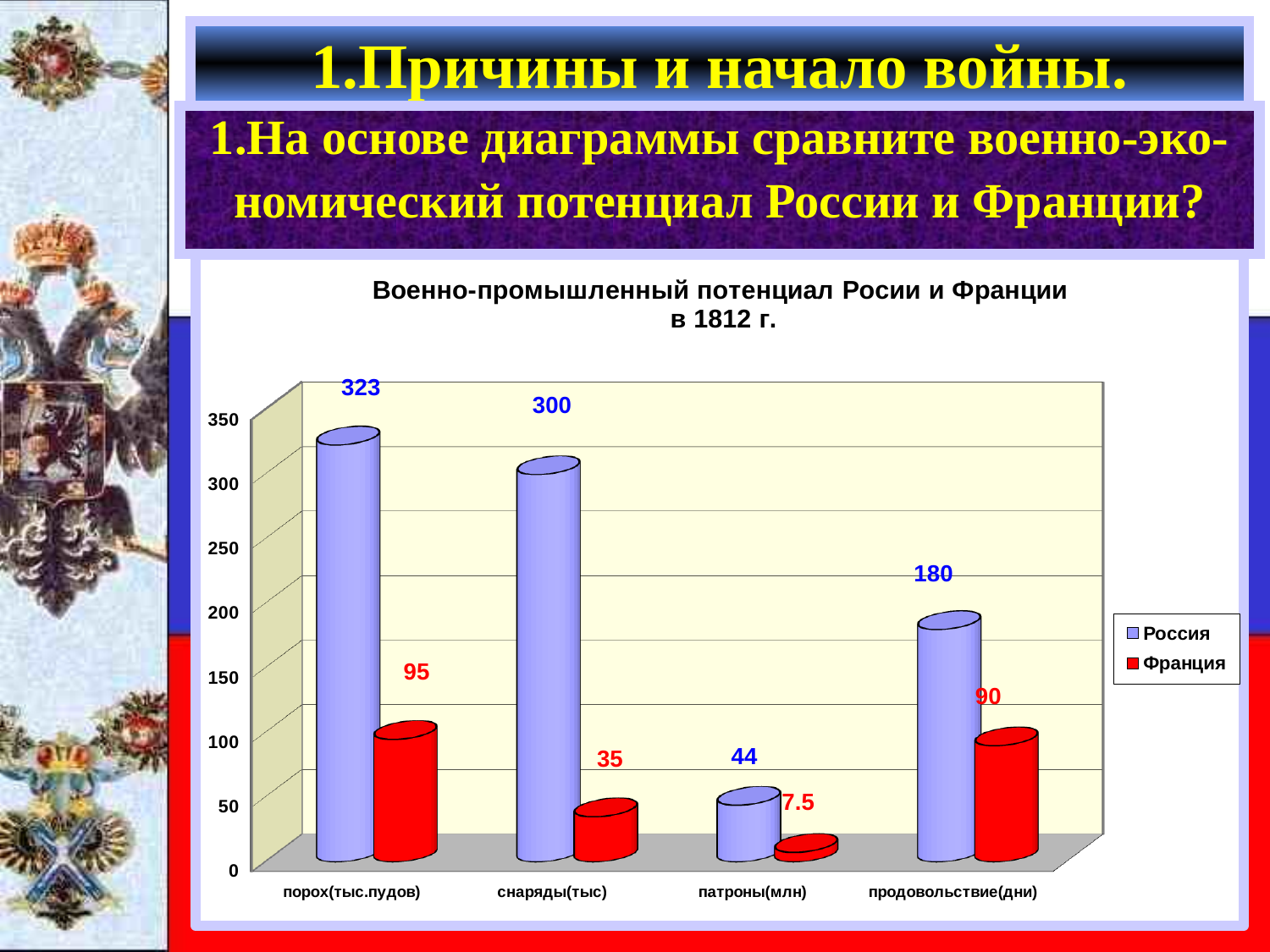
How many series does the legend list? 2 What is the difference between the Россия and Франция values in the продовольствие(дни) category? 90 What is the difference between the Россия and Франция values in the снаряды(тыс) category? 265 What is the value for Франция in the патроны(млн) category? 7.5 What is the value for Россия in the продовольствие(дни) category? 180 What is the value for Россия in the порох(тыс.пудов) category? 323 In which category does Франция have its lowest value? патроны(млн) In which category does Россия have its highest value? порох(тыс.пудов) What kind of chart is shown on the slide? Bar chart How many categories are shown on the x axis? 4 What is the value for Франция in the снаряды(тыс) category? 35 Which is larger: the Россия value for патроны(млн) or the Франция value for порох(тыс.пудов)? Франция value for порох(тыс.пудов)